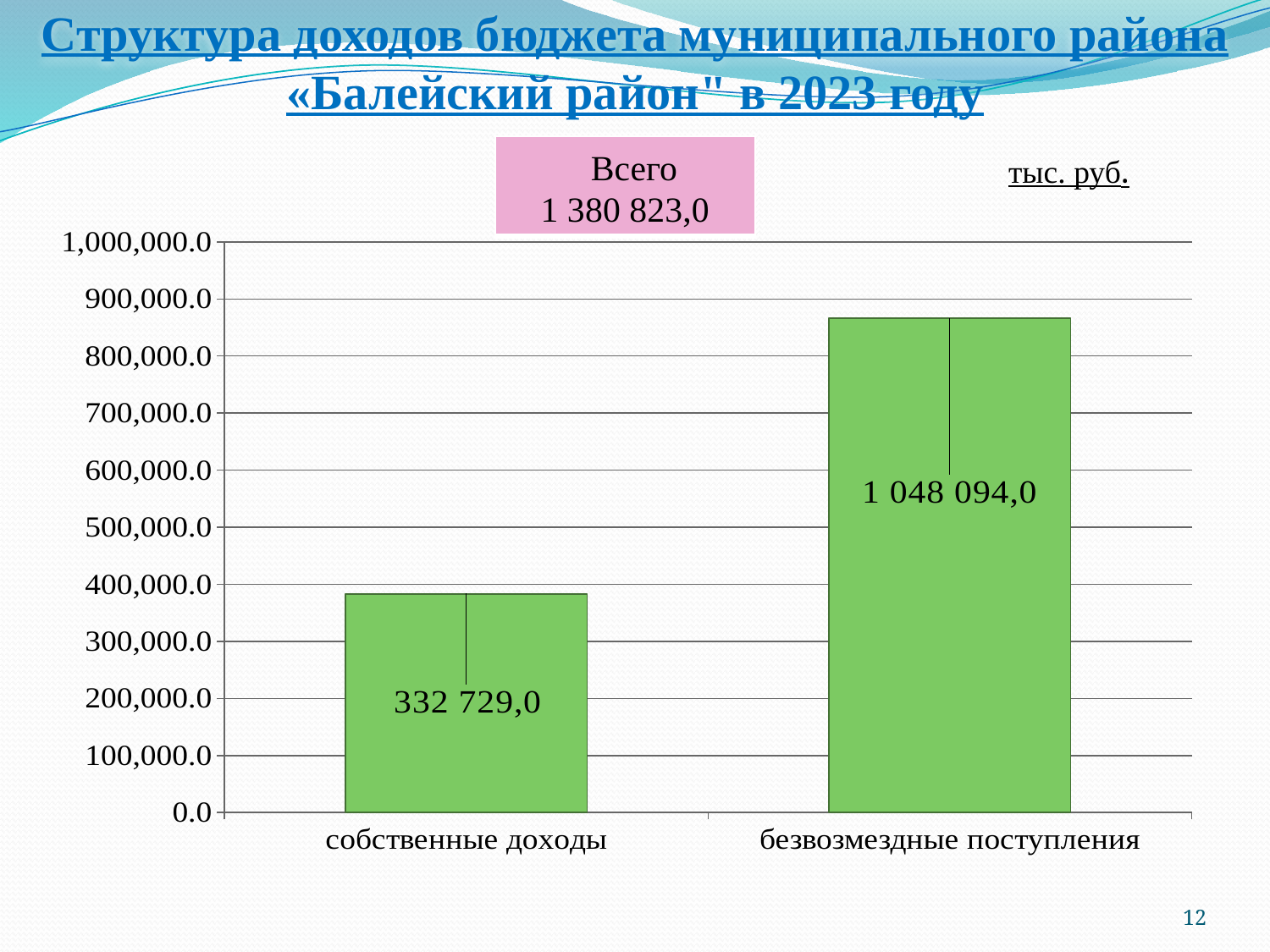
How many categories are shown on the x axis? 2 Which category has the highest value? безвозмездные поступления In what units are the values on the chart given, according to the slide? тыс. руб. What total (Всего) is shown above the chart? 1 380 823,0 Is the value for собственные доходы greater or less than 300,000.0? greater What is the difference between безвозмездные поступления and собственные доходы? 715 365,0 What kind of chart is shown on the slide? bar chart Which is larger, собственные доходы or безвозмездные поступления? безвозмездные поступления Which category has the lowest value? собственные доходы What is the value for безвозмездные поступления? 1 048 094,0 What is the value for собственные доходы? 332 729,0 What colour are the bars in the chart? green